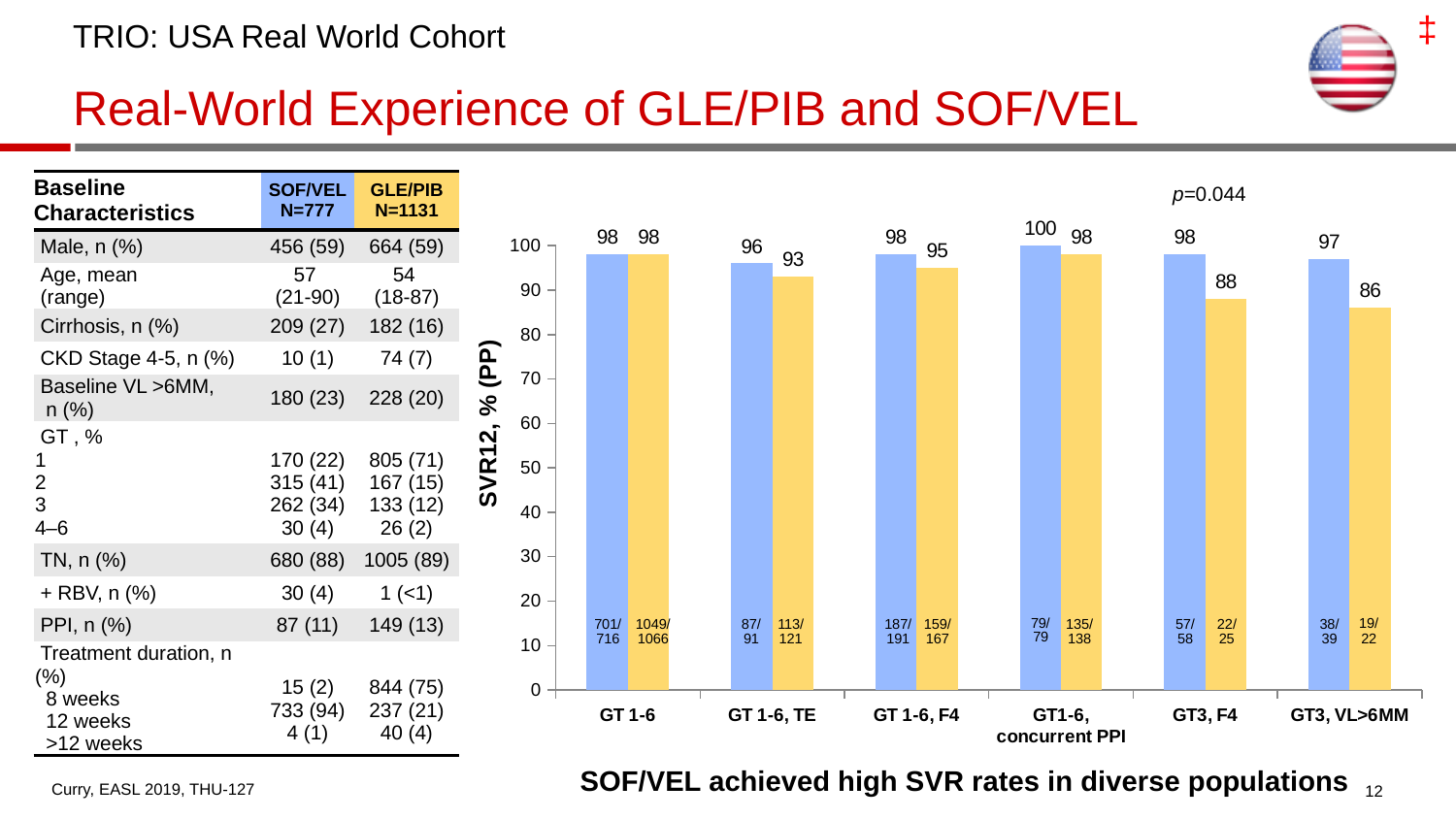
Which group has the lowest SVR12 value among the yellow bars? GT3, VL>6MM What is the SVR12 value shown for the blue bar in the GT1-6, concurrent PPI group? 100 What is the label of the y axis of the chart? SVR12, % (PP) What is the SVR12 value shown for the yellow bar in the GT3, VL>6MM group? 86 How many patient groups are shown on the x axis of the chart? 6 What is the SVR12 value shown for the blue bar in the GT 1-6, TE group? 96 What type of chart is used to show the SVR12 results? bar chart In the GT 1-6, TE group, which bar is higher, the blue bar or the yellow bar? the blue bar What is the difference between the blue and yellow bar values in the GT3, F4 group? 10 Which group has the highest SVR12 value among the blue bars? GT1-6, concurrent PPI What is the difference between the blue and yellow bar values in the GT 1-6, TE group? 3 What is the SVR12 value shown for the yellow bar in the GT3, F4 group? 88